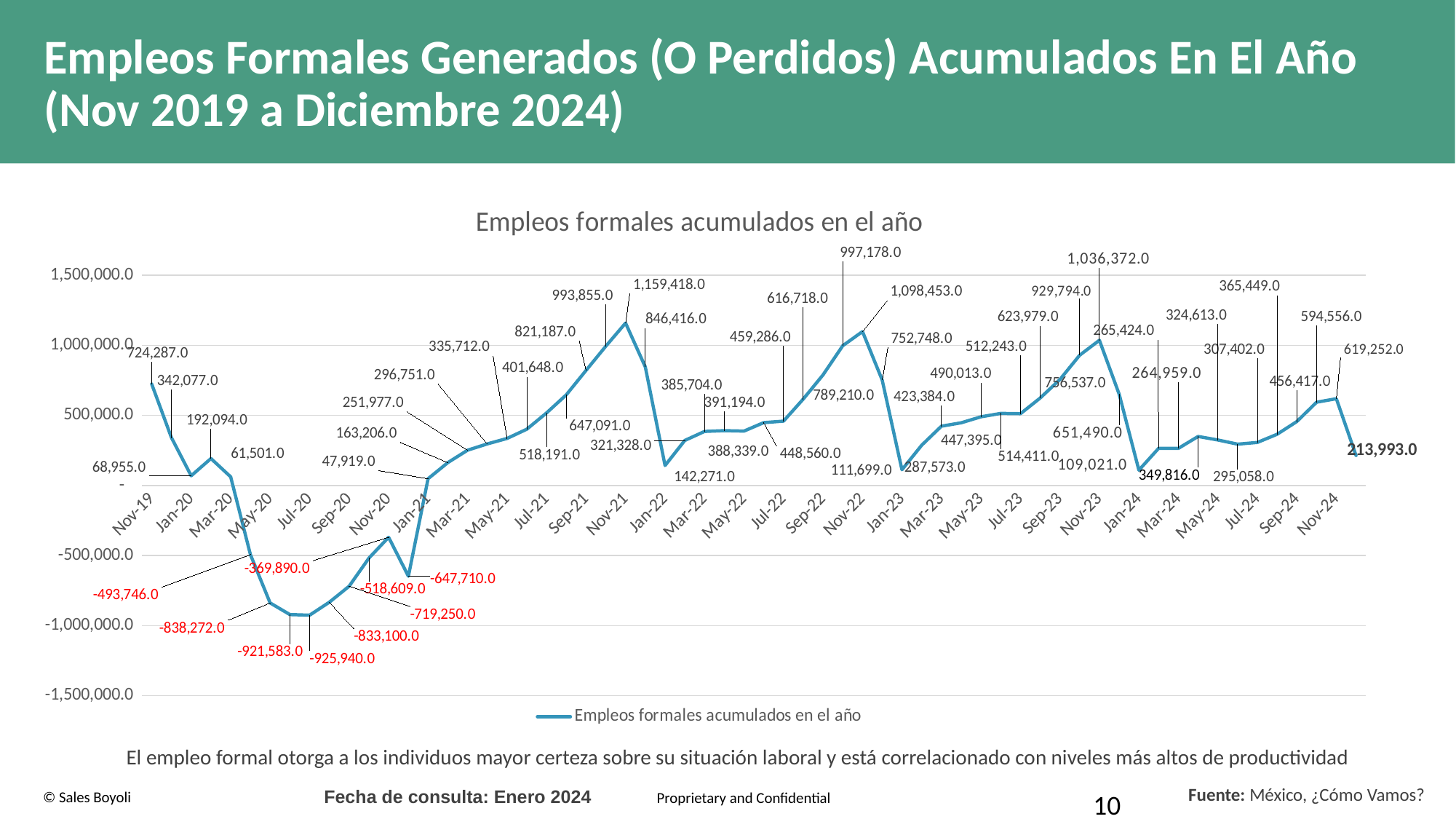
What kind of chart is shown on the slide? line chart What is the highest value labeled on the chart? 1,159,418.0 Is the value for Jan-22 greater or less than 500,000.0? less How many series does the legend list? 1 Do the values rise or fall from Jan-21 to Nov-21? rise What is the value of the last point on the chart (Dec-24)? 213,993.0 What is the title of the chart? Empleos formales acumulados en el año What is the lowest value labeled on the chart? -925,940.0 What is the value for Nov-19, the first point on the chart? 724,287.0 What is the difference between the Nov-21 peak (1,159,418.0) and the Nov-22 peak (1,098,453.0)? 60,965.0 What is the value for Jan-22? 142,271.0 Which is larger, the value for Nov-19 or the value for Dec-24? Nov-19